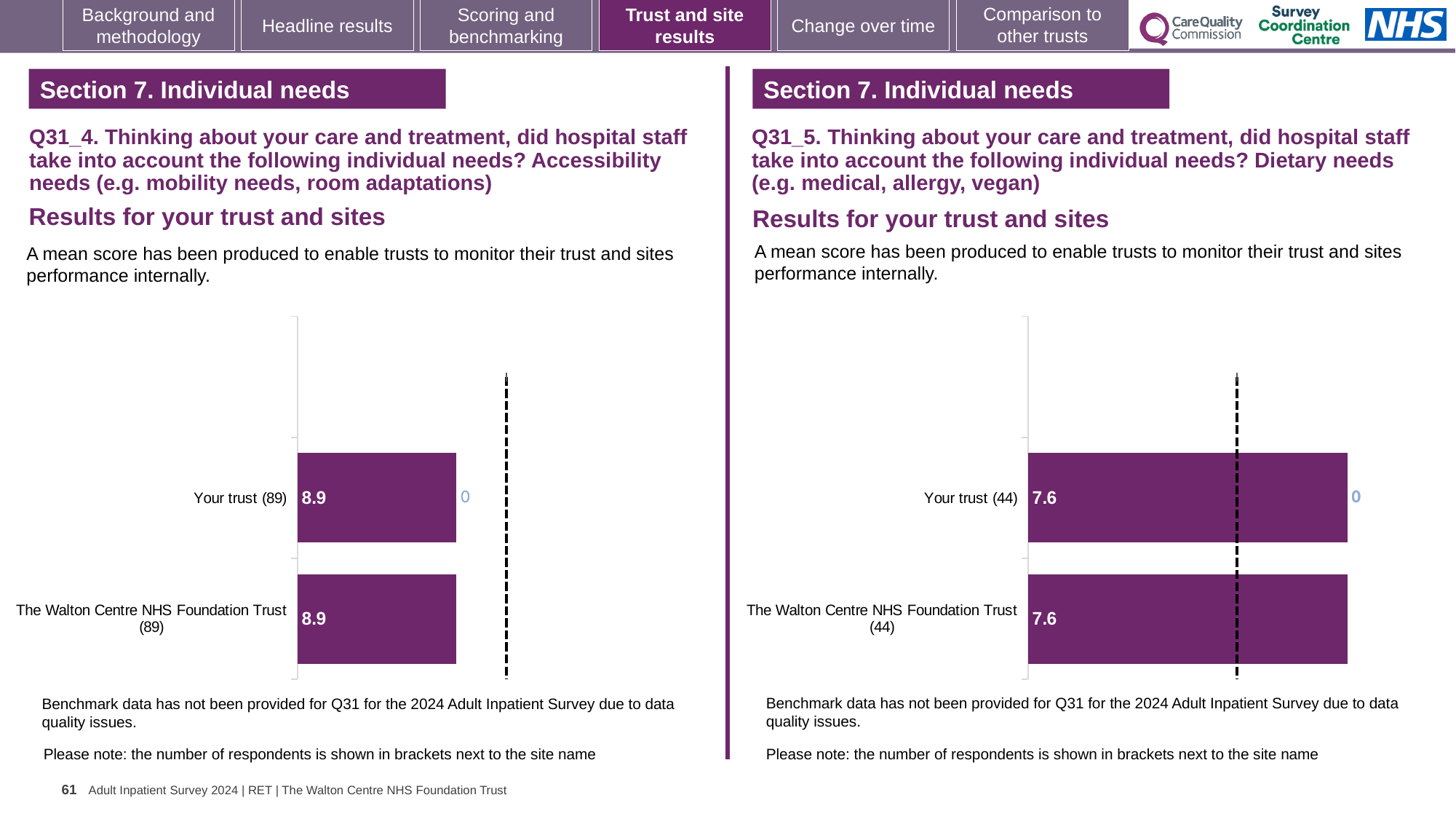
In the left chart (Q31_4, accessibility needs), what is the mean score for Your trust? 8.9 Which is larger: the Your trust score in the left chart (Q31_4) or the Your trust score in the right chart (Q31_5)? Left chart (Q31_4), 8.9 In the right chart (Q31_5, dietary needs), what is the mean score for Your trust? 7.6 In the left chart (Q31_4, accessibility needs), what is the difference between the score for Your trust and the score for The Walton Centre NHS Foundation Trust? 0 In the left chart (Q31_4, accessibility needs), what is the mean score for The Walton Centre NHS Foundation Trust? 8.9 In the right chart (Q31_5, dietary needs), what is the mean score for The Walton Centre NHS Foundation Trust? 7.6 In the right chart (Q31_5, dietary needs), how many respondents are shown in brackets next to The Walton Centre NHS Foundation Trust? 44 In the left chart (Q31_4, accessibility needs), how many respondents are shown in brackets next to Your trust? 89 How many bars are plotted in the right chart (Q31_5, dietary needs)? 2 In the right chart (Q31_5, dietary needs), what is the difference between the score for Your trust and the score for The Walton Centre NHS Foundation Trust? 0 What kind of chart is used in the left chart (Q31_4, accessibility needs)? Bar chart What is the difference between the Your trust score in the left chart (Q31_4) and the Your trust score in the right chart (Q31_5)? 1.3